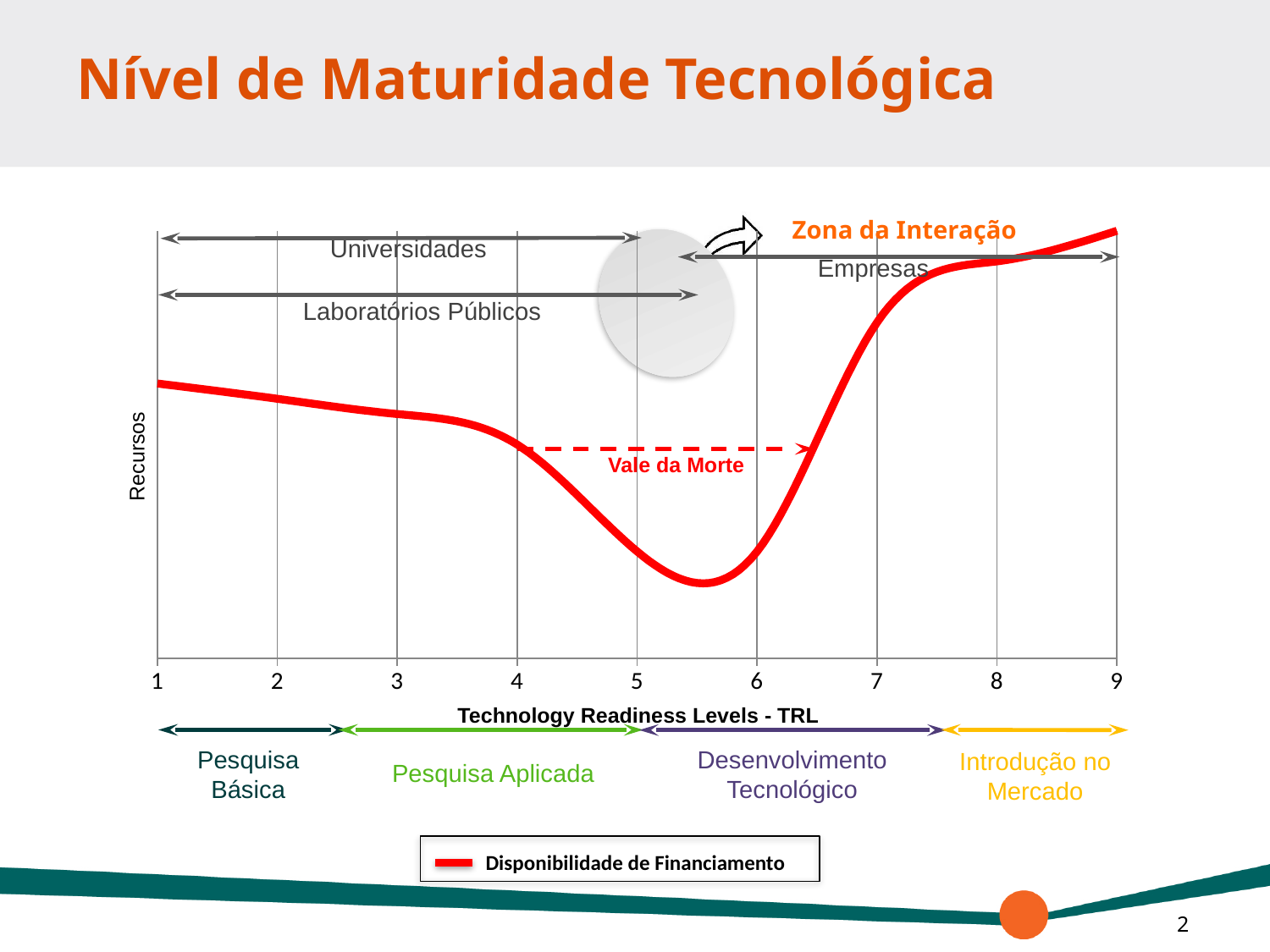
What label is given to the dip in the curve between TRL 4 and TRL 6? Vale da Morte Is the value of the red curve higher at TRL 3 or at TRL 6? TRL 3 Is the value of the red curve higher at TRL 1 or at TRL 5? TRL 1 Is the value of the red curve higher at TRL 9 or at TRL 1? TRL 9 Between which two TRL levels does the red curve reach its lowest point? 5 and 6 Does the red curve rise or fall between TRL 1 and TRL 4? fall Does the red curve rise or fall between TRL 6 and TRL 9? rise What kind of chart is shown on the slide? line chart What does the legend say the red line represents? Disponibilidade de Financiamento How many TRL levels are marked along the x axis? 9 How many series does the legend list? 1